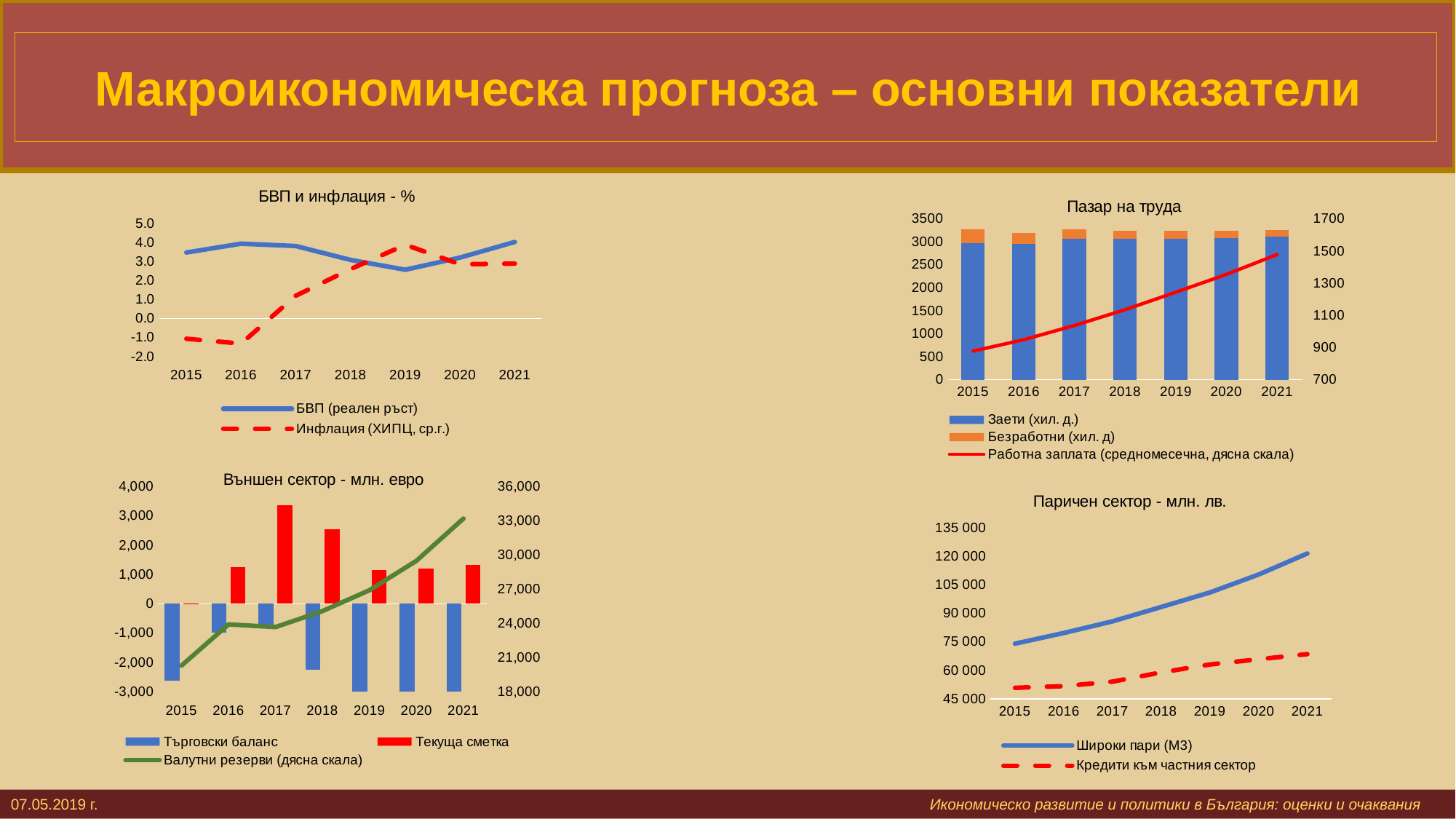
In the 'Външен сектор - млн. евро' chart, in which year is the 'Текуща сметка' bar highest? 2017 In the 'БВП и инфлация - %' chart, in which year is the 'БВП (реален ръст)' line lowest? 2019 In the 'Външен сектор - млн. евро' chart, is the value for 'Текуща сметка' in 2017 greater or less than 3,000? greater How many series does the legend of the 'БВП и инфлация - %' chart list? 2 In the 'Пазар на труда' chart, is the value for 'Заети (хил. д.)' in 2015 greater or less than 2500? greater How many series does the legend of the 'Пазар на труда' chart list? 3 In the 'БВП и инфлация - %' chart, is the value for 'Инфлация (ХИПЦ, ср.г.)' in 2015 greater or less than 0.0? less What kind of chart is the 'БВП и инфлация - %' chart? line chart In the 'БВП и инфлация - %' chart, in which year is the 'Инфлация (ХИПЦ, ср.г.)' line highest? 2019 In the 'Паричен сектор - млн. лв.' chart, which is larger in 2021: 'Широки пари (М3)' or 'Кредити към частния сектор'? Широки пари (М3) In the 'Пазар на труда' chart, does the 'Работна заплата' line rise or fall from 2015 to 2021? rise How many years are shown on the x axis of the 'Паричен сектор - млн. лв.' chart? 7